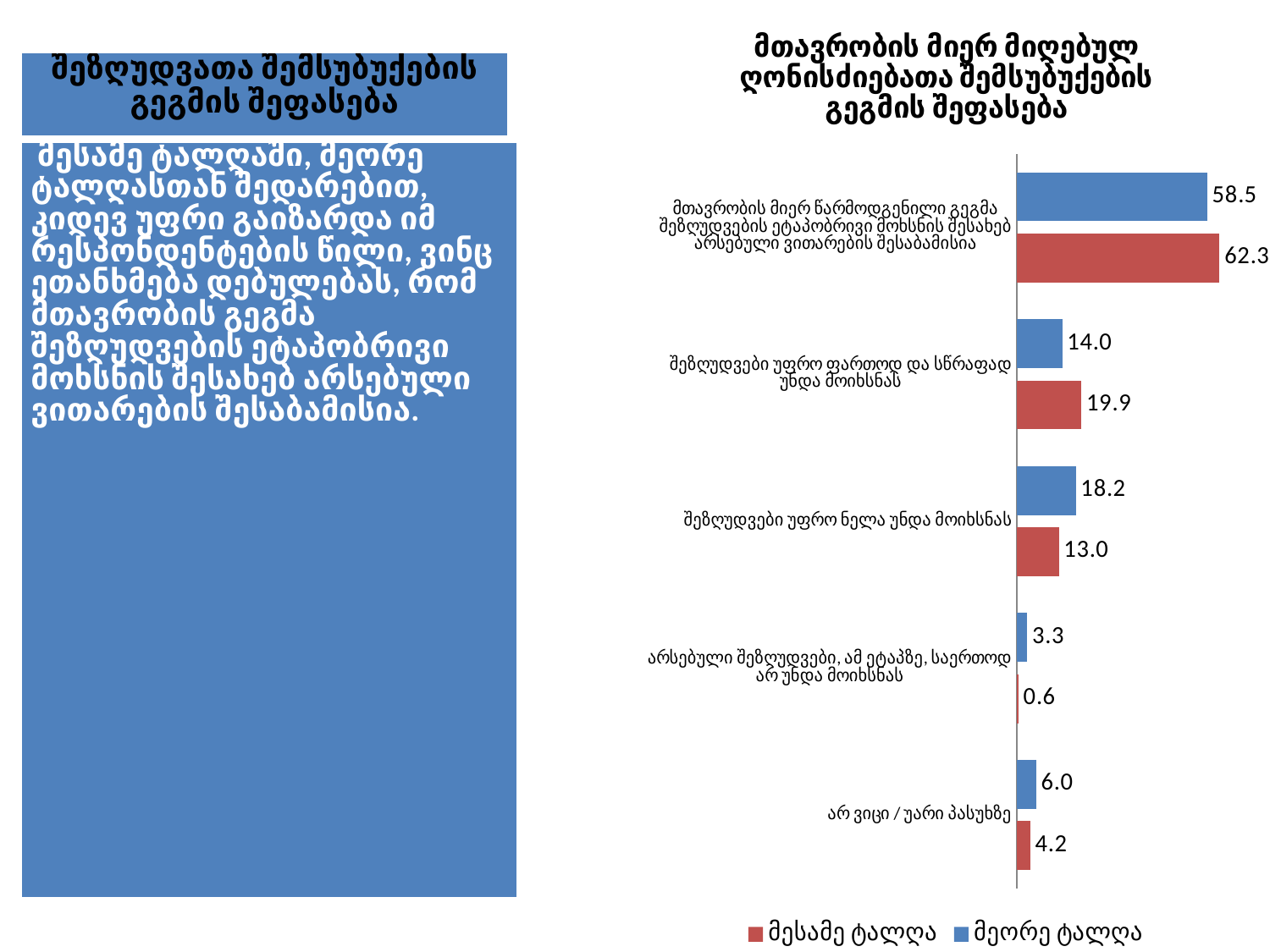
In the category "შეზღუდვები უფრო ნელა უნდა მოიხსნას", which series has the larger value, "მესამე ტალღა" or "მეორე ტალღა"? მეორე ტალღა What is the difference between the "მესამე ტალღა" and "მეორე ტალღა" values for the top category ("მთავრობის მიერ წარმოდგენილი გეგმა...")? 3.8 How many categories are shown in the chart? 5 What is the value for "მესამე ტალღა" in the category "არსებული შეზღუდვები, ამ ეტაპზე, საერთოდ არ უნდა მოიხსნას"? 0.6 What kind of chart is shown on the slide? Bar chart Which colour represents "მესამე ტალღა" in the chart? Red What is the value for "მეორე ტალღა" in the category "არ ვიცი / უარი პასუხზე"? 6.0 What is the value for "მესამე ტალღა" in the category "შეზღუდვები უფრო ნელა უნდა მოიხსნას"? 13.0 Which category has the lowest value for "მეორე ტალღა"? არსებული შეზღუდვები, ამ ეტაპზე, საერთოდ არ უნდა მოიხსნას How many series does the legend list? 2 Which category has the highest value for "მესამე ტალღა"? მთავრობის მიერ წარმოდგენილი გეგმა შეზღუდვების ეტაპობრივი მოხსნის შესახებ არსებული ვითარების შესაბამისია What is the value for "მესამე ტალღა" in the category "შეზღუდვები უფრო ფართოდ და სწრაფად უნდა მოიხსნას"? 19.9